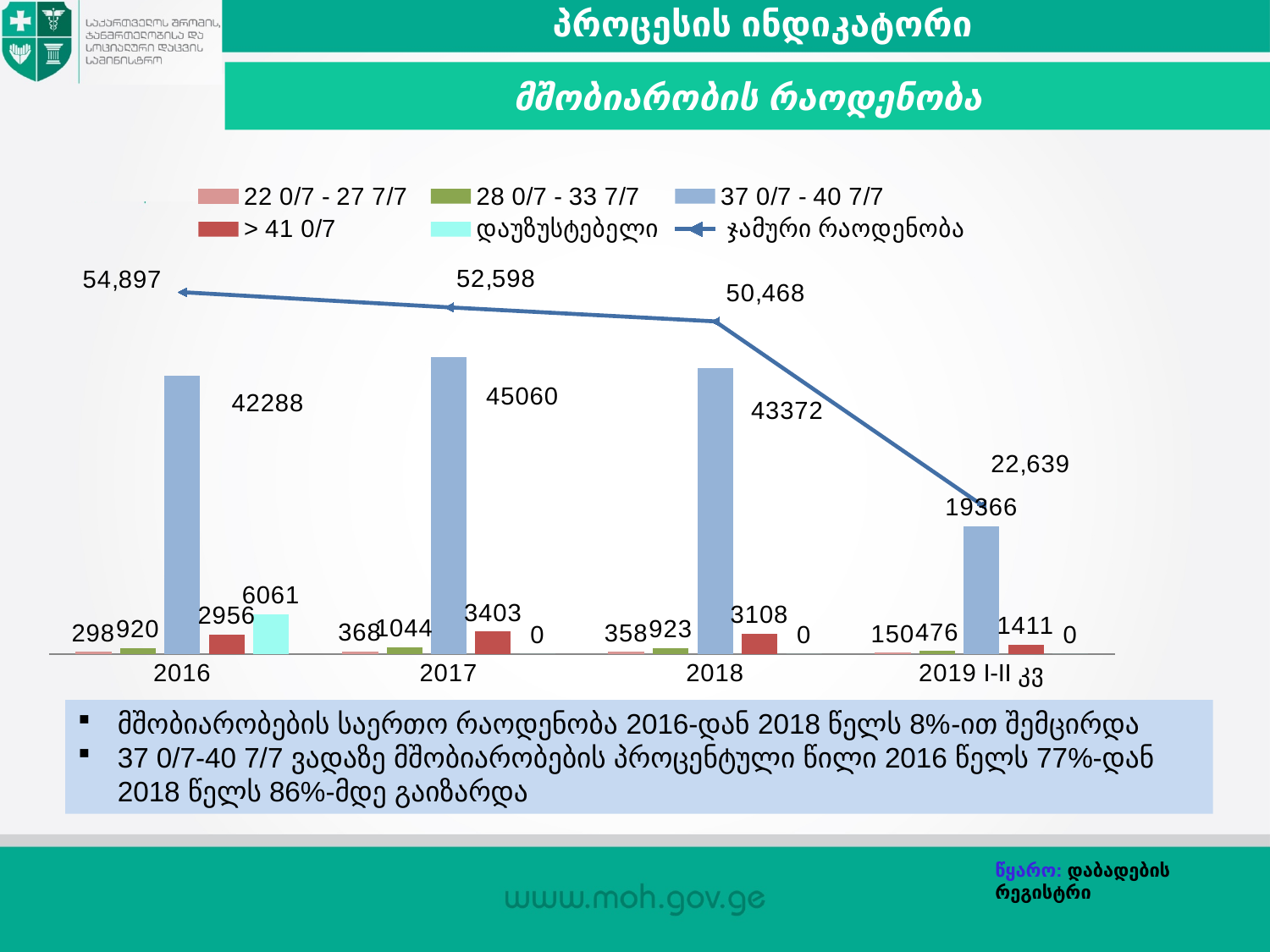
Which is larger: the 28 0/7 - 33 7/7 value for 2017 or for 2018? 2017 How many series does the legend list? 6 What is the value of the 37 0/7 - 40 7/7 series for 2017? 45060 Which category has the lowest value for the 37 0/7 - 40 7/7 series? 2019 I-II კვ What kind of chart is this? Combined bar and line chart How many categories are shown on the x axis? 4 What is the difference between the totals for 2016 and 2018? 4,429 Does the total line (ჯამური რაოდენობა) rise or fall from 2016 to 2019 I-II კვ? Fall What is the value of the დაუზუსტებელი series for 2016? 6061 Which year has the highest total (ჯამური რაოდენობა)? 2016 What is the total (ჯამური რაოდენობა) shown for 2016? 54,897 What is the value of the > 41 0/7 series for 2018? 3108